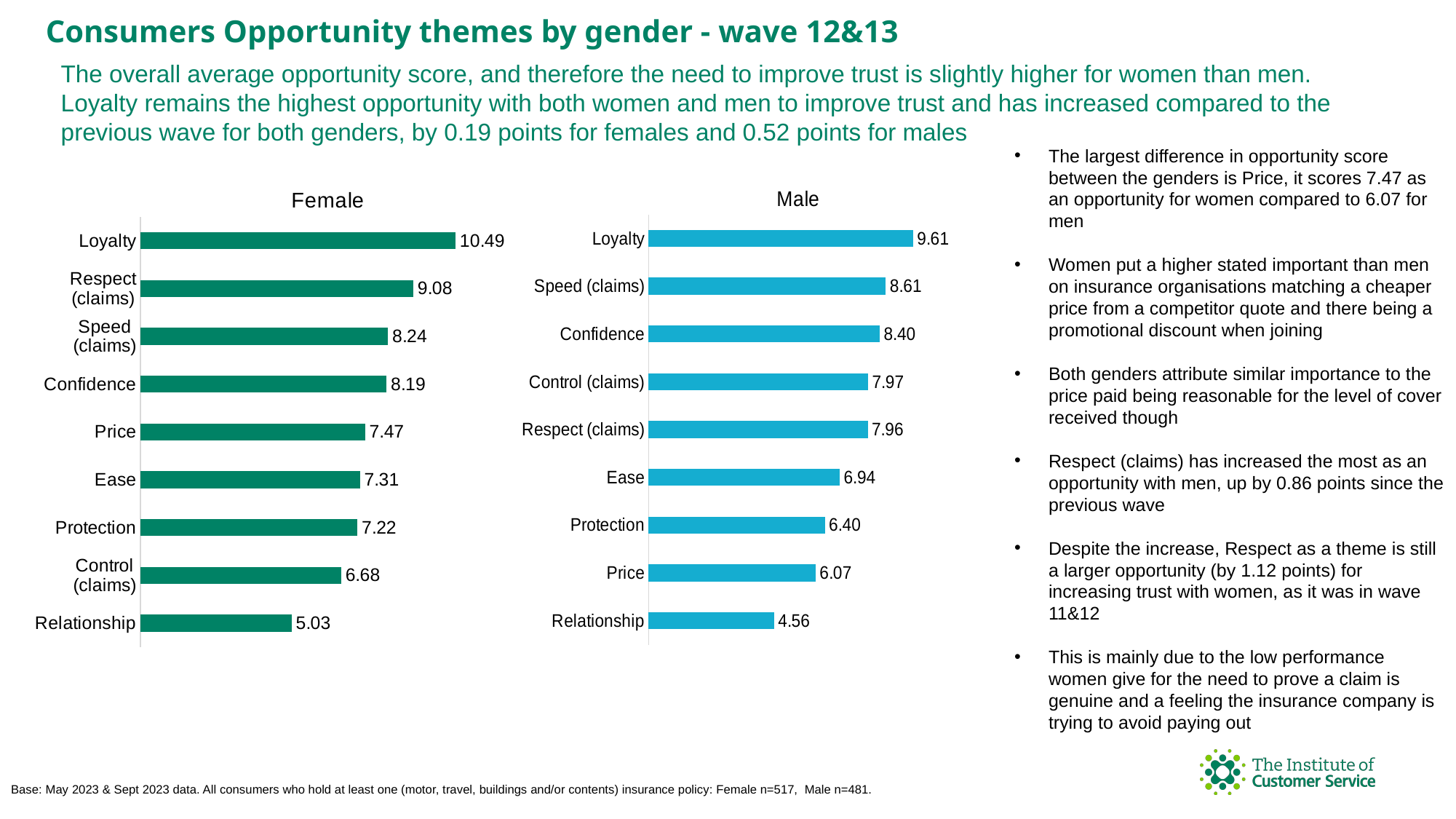
In the Female chart, which category has the highest value? Loyalty How many categories are shown in the Female chart? 9 In the Male chart, what is the value for Confidence? 8.40 In the Male chart, what is the difference between Loyalty and Relationship? 5.05 In the Female chart, what is the difference between Price and Ease? 0.16 In the Male chart, which category has the lowest value? Relationship What kind of chart is the Male chart? Bar chart In the Female chart, what is the value for Loyalty? 10.49 In the Male chart, which is larger: Speed (claims) or Ease? Speed (claims) In the Female chart, what is the value for Control (claims)? 6.68 Which is larger: Price in the Female chart or Price in the Male chart? Price in the Female chart What is the title of the chart on the left? Female